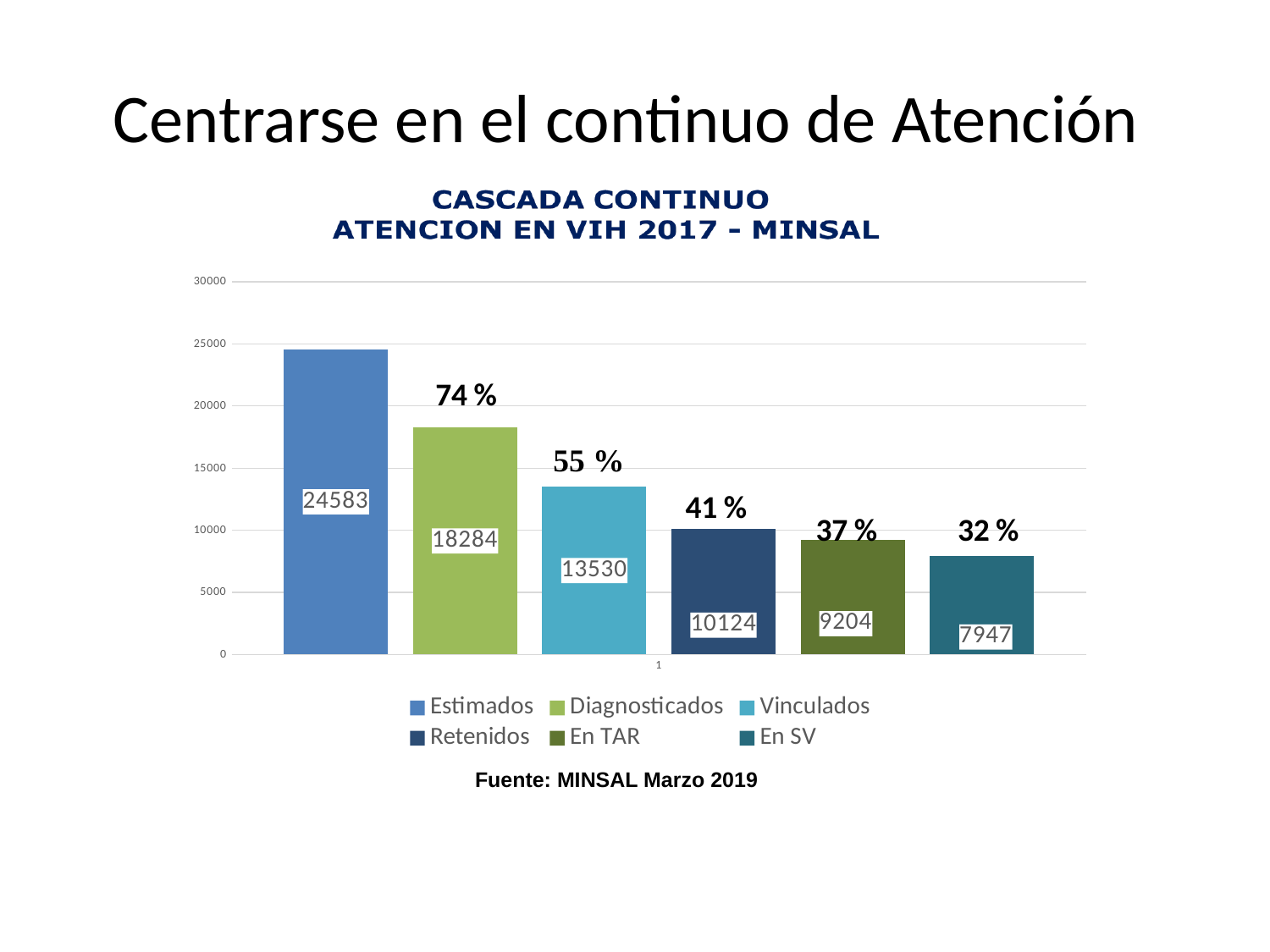
Which is larger, the value for Vinculados or the value for Retenidos? Vinculados What percentage is shown above the Retenidos bar? 41 % What kind of chart is shown? Bar chart How many series does the legend list? 6 What is the value for Diagnosticados? 18284 Which series has the lowest value? En SV Which series has the highest value? Estimados What is the value for Estimados? 24583 What is the difference between the values for Estimados and Diagnosticados? 6299 What is the value for Vinculados? 13530 What is the difference between the values for Retenidos and En TAR? 920 What is the value for En SV? 7947